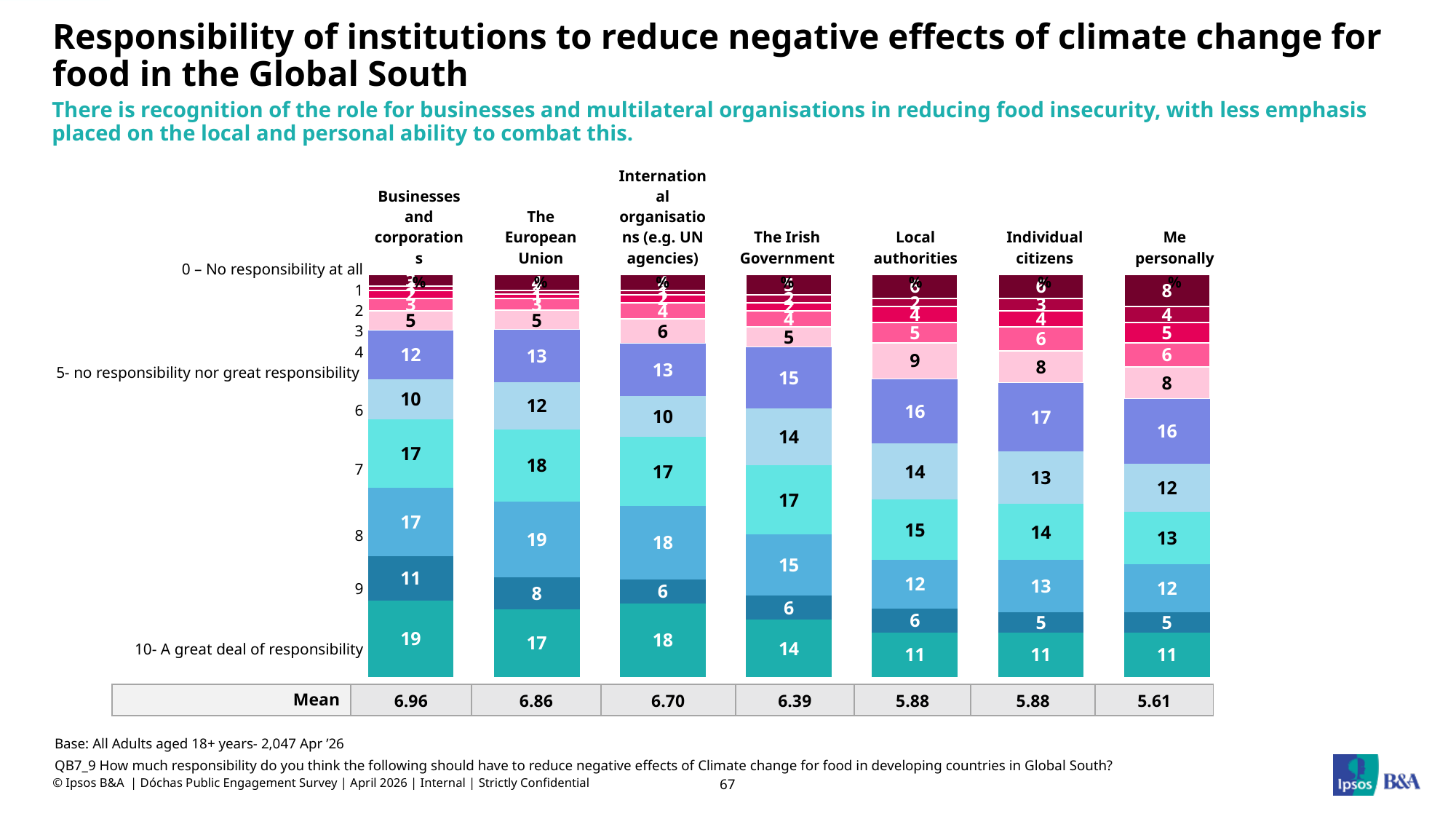
What percentage gave The Irish Government a score of 10 (a great deal of responsibility)? 14 What is the difference between the percentage giving a score of 10 to Businesses and corporations and the percentage giving a score of 10 to Me personally? 8 What is the mean score shown for Local authorities? 5.88 Which institution has the highest mean score? Businesses and corporations What is the difference between the mean score for Businesses and corporations and the mean score for Me personally? 1.35 How many institutions (bars) are shown in the chart? 7 What is the mean score for Businesses and corporations? 6.96 Which has the higher mean score, The European Union or International organisations (e.g. UN agencies)? The European Union What kind of chart is shown on the slide? Stacked bar chart What percentage gave Me personally a score of 0 (no responsibility at all)? 8 Which institution has the lowest mean score? Me personally What percentage gave Businesses and corporations a score of 10 (a great deal of responsibility)? 19